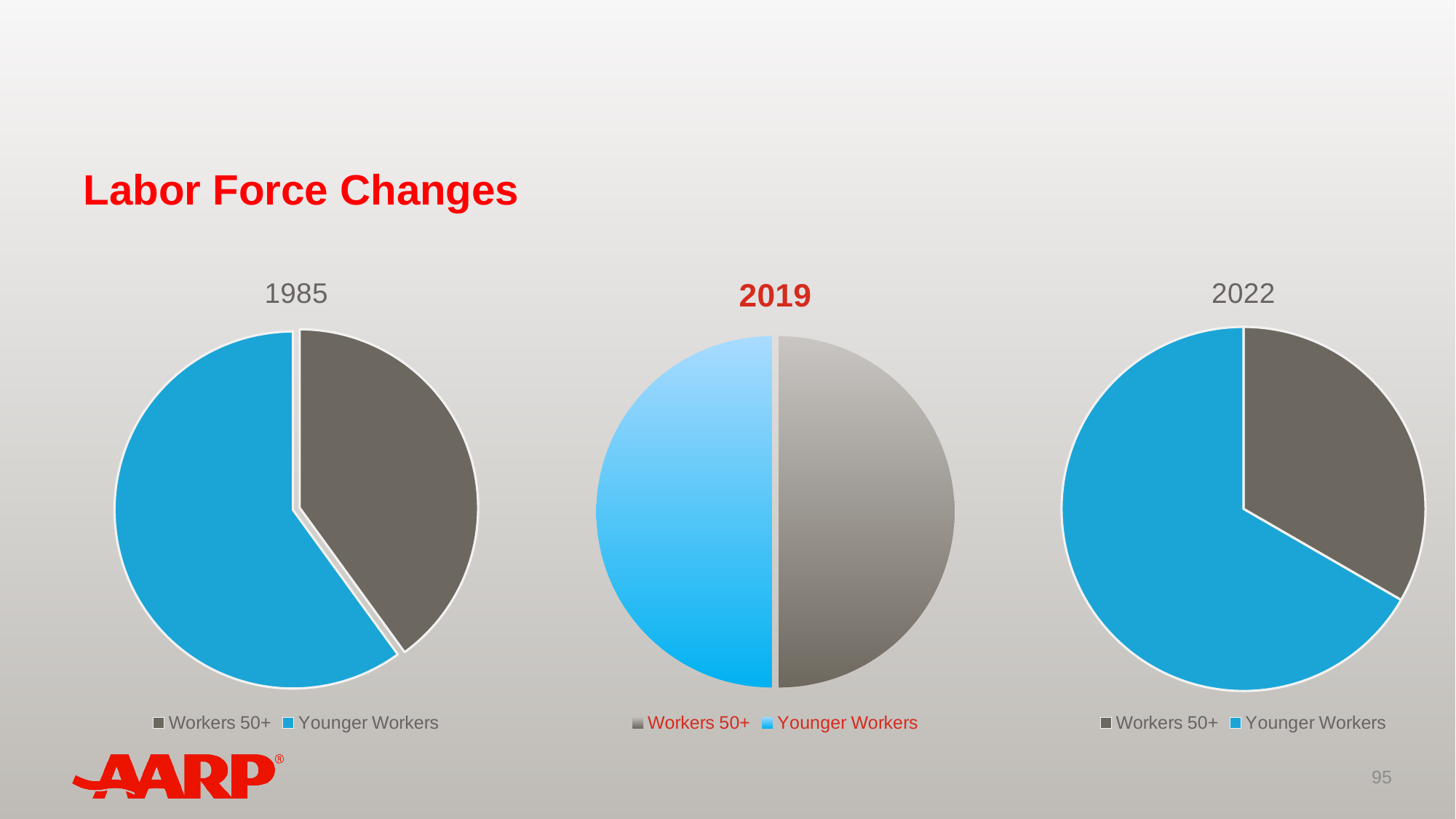
What is the title of the slide containing the three pie charts? Labor Force Changes In the 2022 pie chart, which colour represents Workers 50+? gray What kind of chart is the 2022 chart? pie chart In the 2022 pie chart, which category has the largest slice? Younger Workers Which years are shown as the titles of the three pie charts? 1985, 2019, 2022 In the 2022 pie chart, which slice is larger, Workers 50+ or Younger Workers? Younger Workers How many slices does the 1985 pie chart have? 2 In the 1985 pie chart, which category has the smallest slice? Workers 50+ How many pie charts are shown on the slide? 3 How many entries does the legend of the 2019 chart list? 2 In the 1985 pie chart, which slice is larger, Workers 50+ or Younger Workers? Younger Workers What kind of chart is the 1985 chart? pie chart